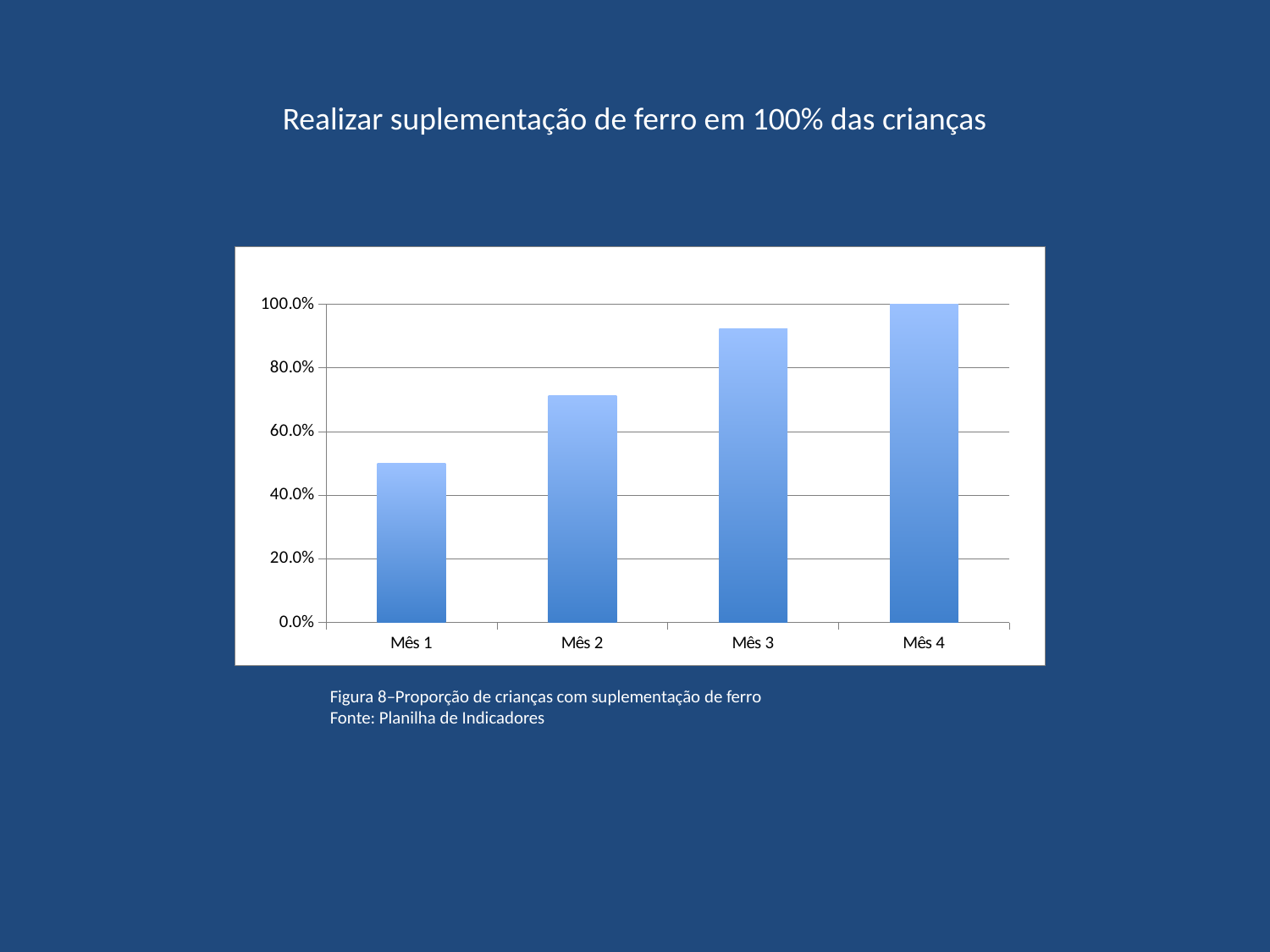
Which month has the lowest value? Mês 1 How many categories (months) are shown on the x axis? 4 What kind of chart is shown on the slide? bar chart Which month has the highest value? Mês 4 Is the value for Mês 3 greater or less than 80.0%? greater Do the values rise or fall from Mês 1 to Mês 4? rise What is the title shown above the chart? Realizar suplementação de ferro em 100% das crianças Which is larger, the value for Mês 2 or the value for Mês 3? Mês 3 Is the value for Mês 2 greater or less than 60.0%? greater What source is cited below the chart? Planilha de Indicadores Is the value for Mês 1 greater or less than 60.0%? less